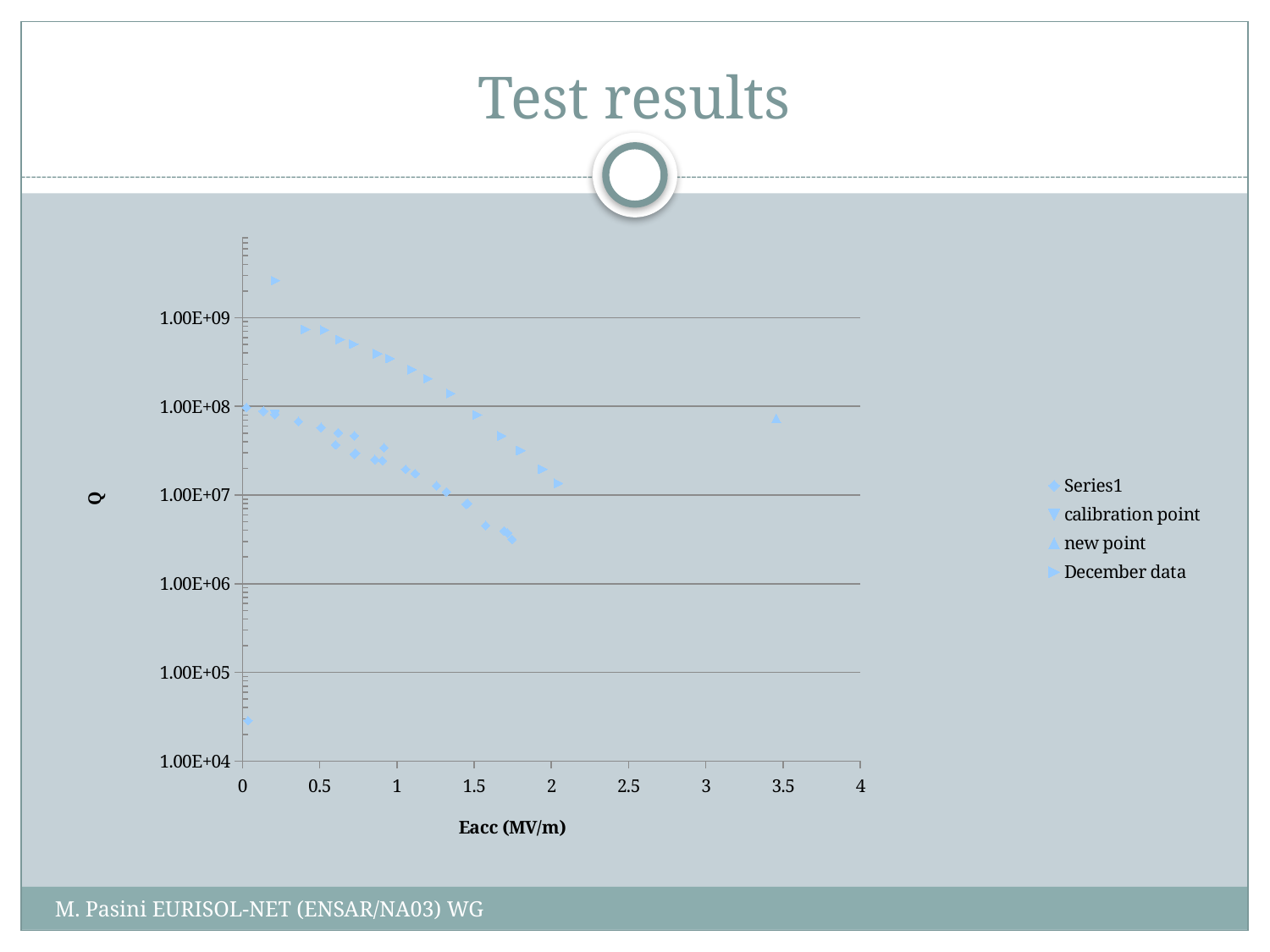
Is the Q value of the lowest Series1 point (near 0 MV/m) greater or less than 1.00E+05? less Is the Q value of the 'new point' (at about 3.5 MV/m) greater or less than 1.00E+08? less At about 1.5 MV/m, which series has the larger Q value: Series1 or December data? December data Is the Q value of the last 'December data' point (near 2 MV/m) greater or less than 1.00E+07? greater What is the highest value shown on the x axis? 4 Do the Series1 Q values rise or fall as Eacc increases? fall What is the label of the x axis? Eacc (MV/m) How many series does the legend list? 4 Do the 'December data' Q values rise or fall as Eacc increases? fall What is the label of the y axis? Q What kind of chart is shown on the slide? scatter chart